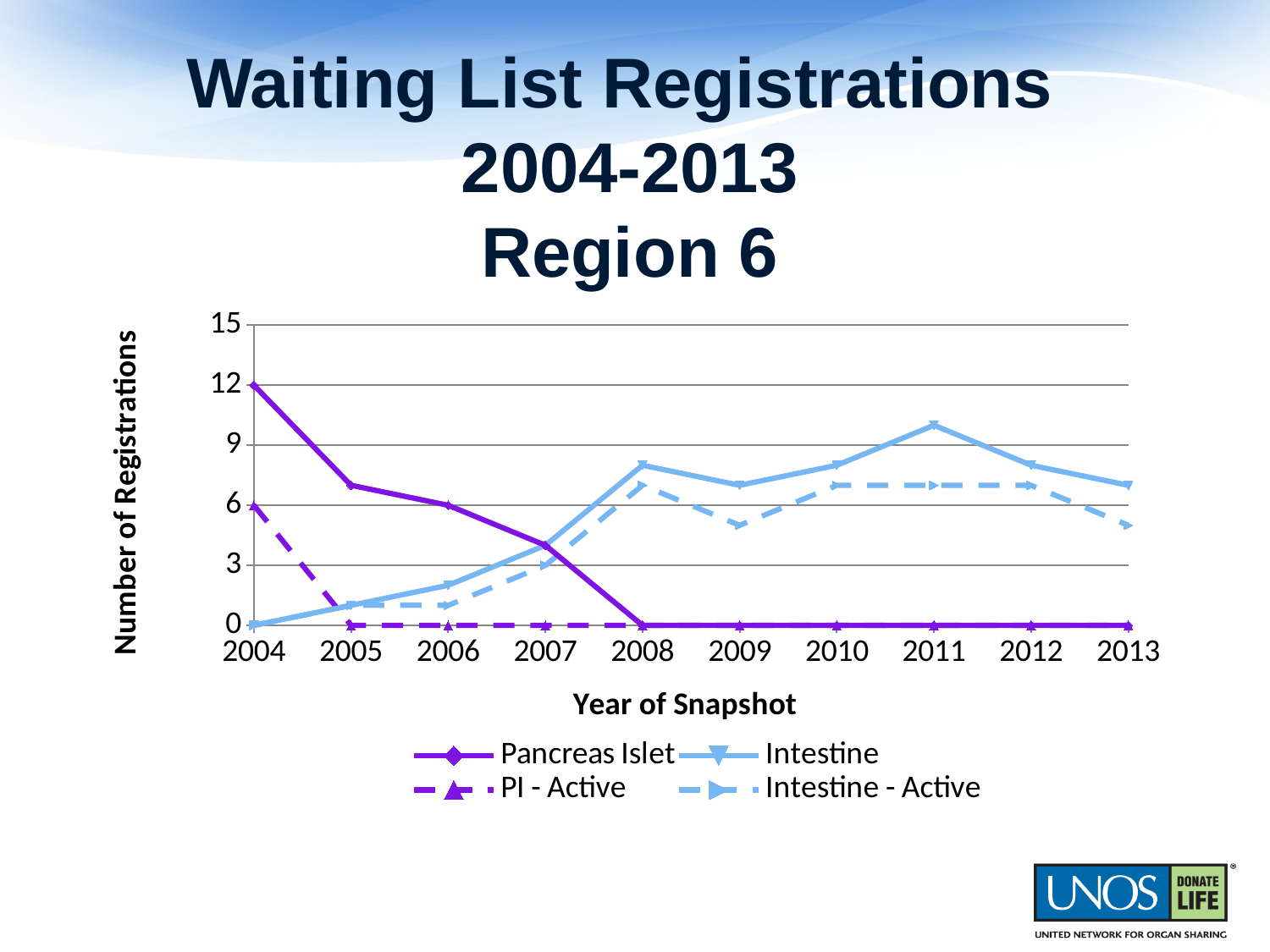
Is the value for Intestine in 2005 greater or less than 3? less How many years are shown on the x axis? 10 What is the value for Pancreas Islet in 2006? 6 What is the difference between the Pancreas Islet values in 2004 and 2006? 6 What type of chart is shown on the slide? line chart What is the value for PI - Active in 2004? 6 How many series does the legend list? 4 In 2010, which is larger: Intestine or Pancreas Islet? Intestine What is the value for Pancreas Islet in 2004? 12 Is the value for Intestine in 2011 greater or less than 9? greater In which year is the Intestine series at its highest? 2011 What is the value for Pancreas Islet in 2008? 0